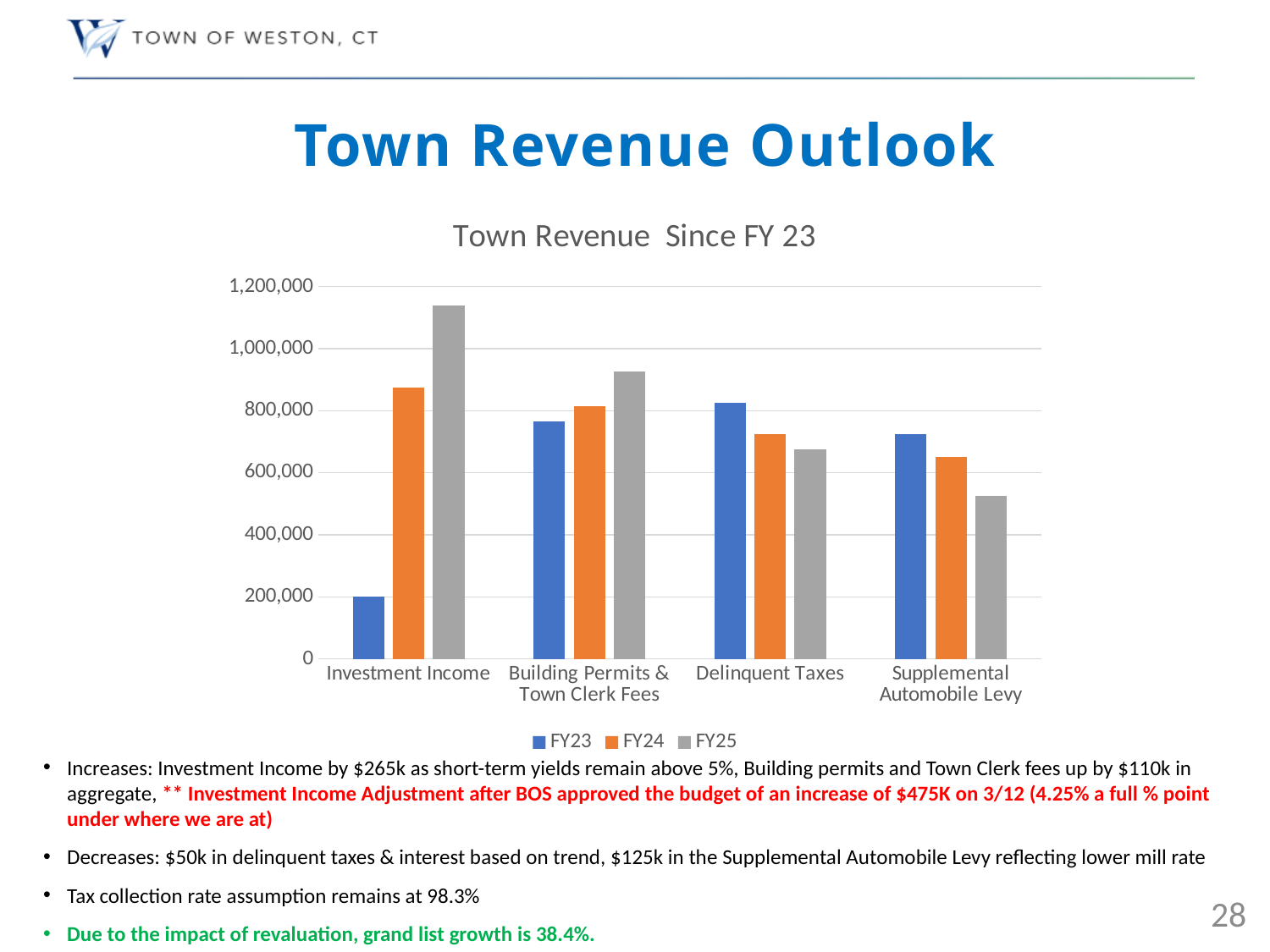
How many revenue categories are shown on the x axis of the chart? 4 Which category has the highest FY25 bar? Investment Income Is the FY25 value for Investment Income greater or less than 1,000,000? greater How many series does the legend list in the Town Revenue Since FY 23 chart? 3 What is the title of the chart? Town Revenue Since FY 23 Is the FY23 value for Investment Income greater or less than 400,000? less For Supplemental Automobile Levy, which is larger: the FY23 value or the FY25 value? FY23 Do the Delinquent Taxes bars rise or fall from FY23 to FY25? fall Do the Investment Income bars rise or fall from FY23 to FY25? rise What kind of chart is shown on the slide? Bar chart Which category has the lowest FY23 bar? Investment Income Is the FY25 value for Supplemental Automobile Levy greater or less than 600,000? less